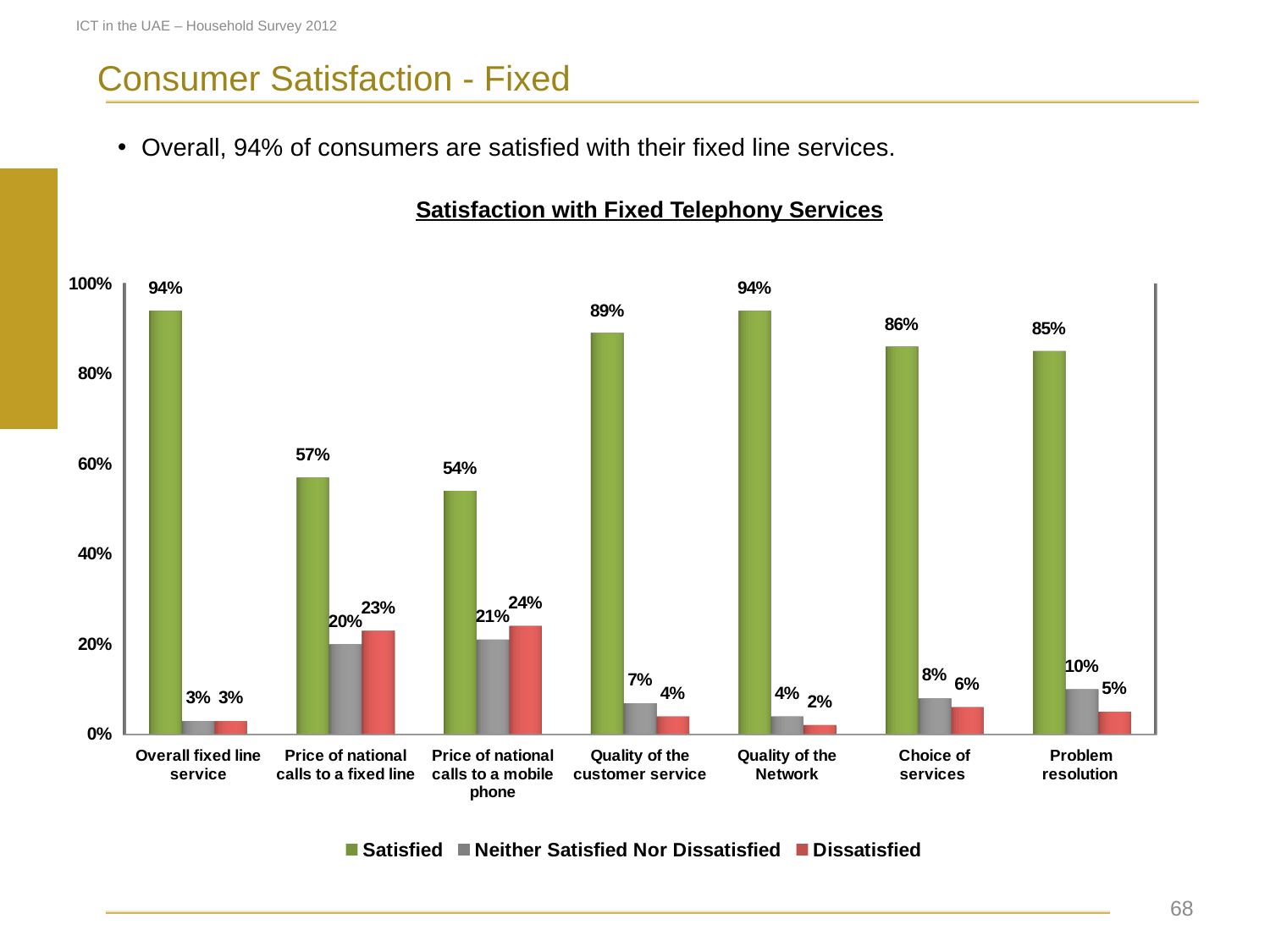
How many series does the legend list? 3 What kind of chart is shown on the slide? Bar chart Which colour represents the Dissatisfied series? Red What is the difference between the Satisfied values for Overall fixed line service and Price of national calls to a fixed line? 37% Which is larger: the Satisfied value for Choice of services or for Problem resolution? Choice of services How many categories are shown on the x axis? 7 What is the title of the chart? Satisfaction with Fixed Telephony Services Which category has the highest Dissatisfied percentage? Price of national calls to a mobile phone What percentage of consumers are satisfied with the Price of national calls to a mobile phone? 54% What is the Dissatisfied value for Quality of the Network? 2% Which category has the lowest Satisfied percentage? Price of national calls to a mobile phone What is the Neither Satisfied Nor Dissatisfied value for Problem resolution? 10%